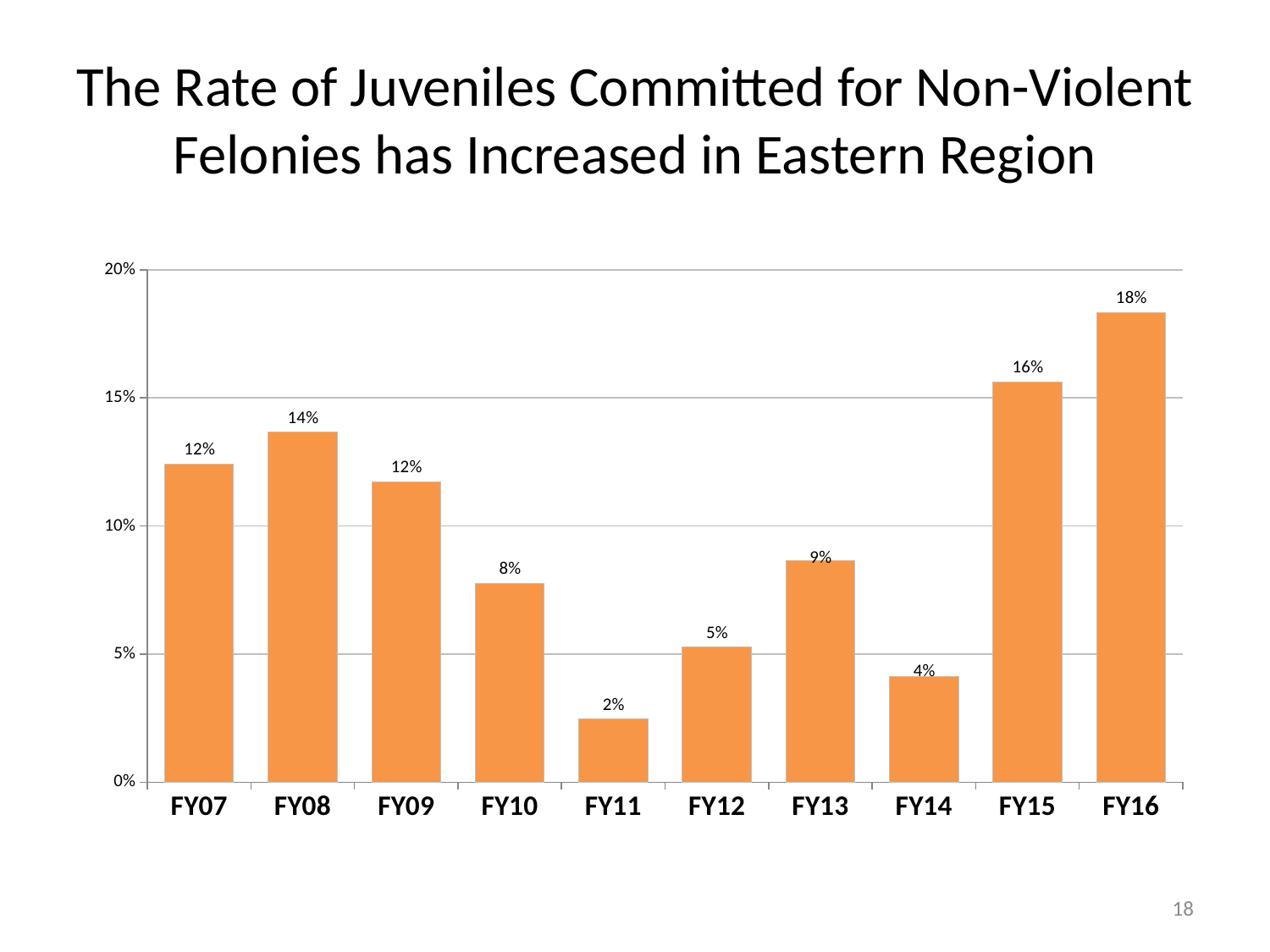
Which fiscal year has the highest value? FY16 What is the difference between the values for FY16 and FY11? 16% Which fiscal year has the lowest value? FY11 What kind of chart is shown on the slide? bar chart Is the value for FY15 greater or less than 15%? greater What is the title of the slide? The Rate of Juveniles Committed for Non-Violent Felonies has Increased in Eastern Region How many fiscal years are shown on the x axis? 10 What is the value for FY07? 12% What is the value for FY14? 4% What is the value for FY11? 2% Which is larger, the value for FY08 or the value for FY10? FY08 Do the values rise or fall from FY14 to FY16? rise